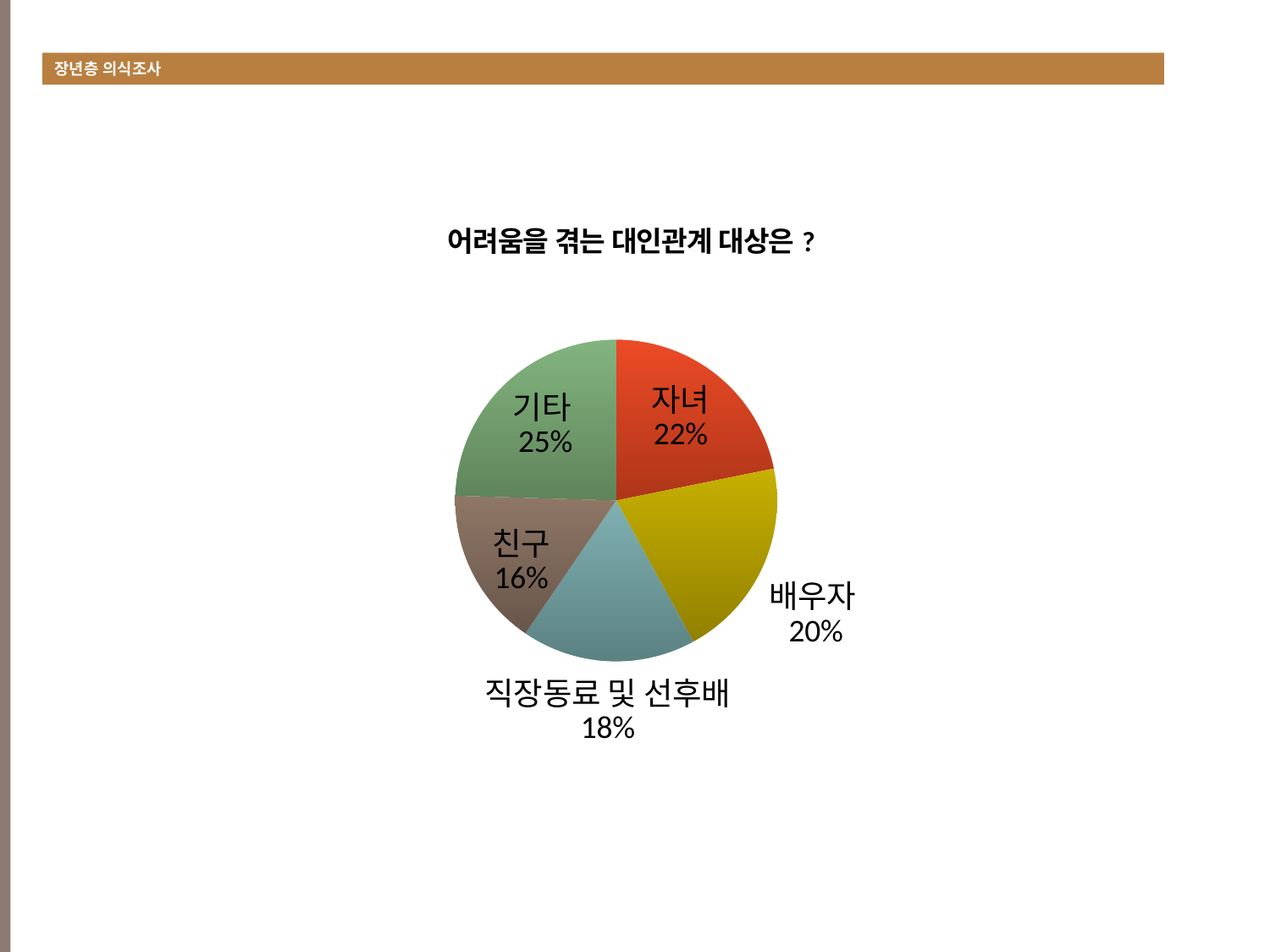
What percentage of the pie is labelled 자녀? 22% What percentage of the pie is labelled 직장동료 및 선후배? 18% What is the title of the chart? 어려움을 겪는 대인관계 대상은 ? Which slice of the pie chart is the largest? 기타 What kind of chart is shown on the slide? pie chart How many slices does the pie chart have? 5 Which slice is larger, 자녀 or 배우자? 자녀 What percentage of the pie is labelled 친구? 16% What percentage of the pie is labelled 기타? 25% Which slice of the pie chart is the smallest? 친구 What is the difference in percentage points between the 기타 slice and the 친구 slice? 9 What percentage of the pie is labelled 배우자? 20%